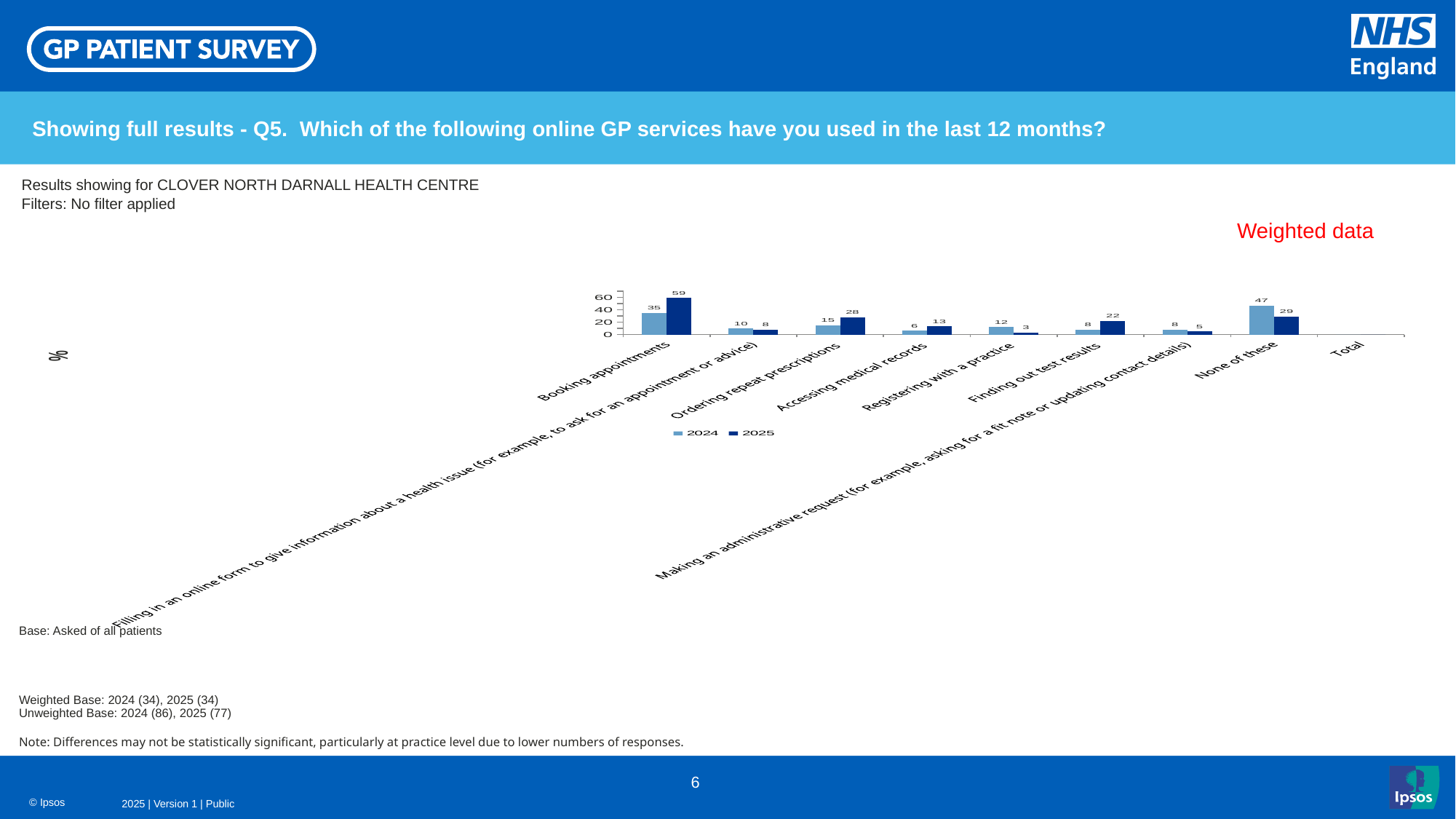
Which category has the lowest 2025 value? Registering with a practice What is the 2025 value for Booking appointments? 59 What is the 2025 value for Finding out test results? 22 Which is larger for Accessing medical records, the 2024 value or the 2025 value? 2025 What kind of chart is shown on the slide? Bar chart What is the difference between the 2025 and 2024 values for Booking appointments? 24 Which two years are listed in the chart legend? 2024 and 2025 What is the difference between the 2024 and 2025 values for None of these? 18 What is the 2024 value for Ordering repeat prescriptions? 15 How many series does the legend list? 2 What is the 2024 value for None of these? 47 Which category has the highest 2025 value? Booking appointments